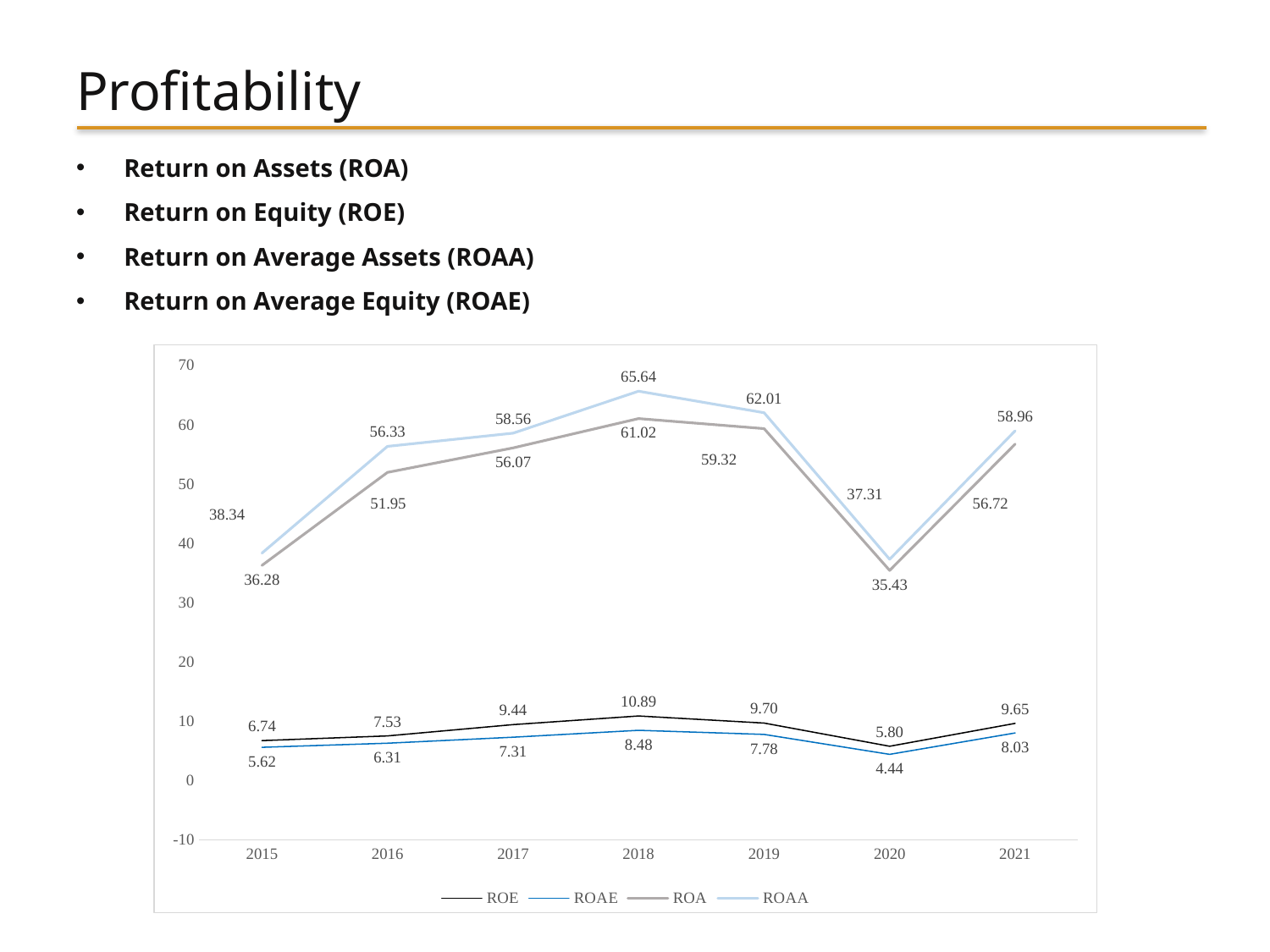
Does ROA rise or fall from 2019 to 2020? fall What is the ROAA value for 2018? 65.64 What type of chart is shown on the slide? line chart What is the ROE value for 2017? 9.44 How many years are shown on the x axis? 7 What is the ROAE value for 2021? 8.03 How many series does the legend list? 4 In which year is ROE highest? 2018 What is the ROA value for 2020? 35.43 What is the difference between ROAA and ROA in 2019? 2.69 Which is larger in 2016, ROE or ROAE? ROE In which year is ROAA lowest? 2020